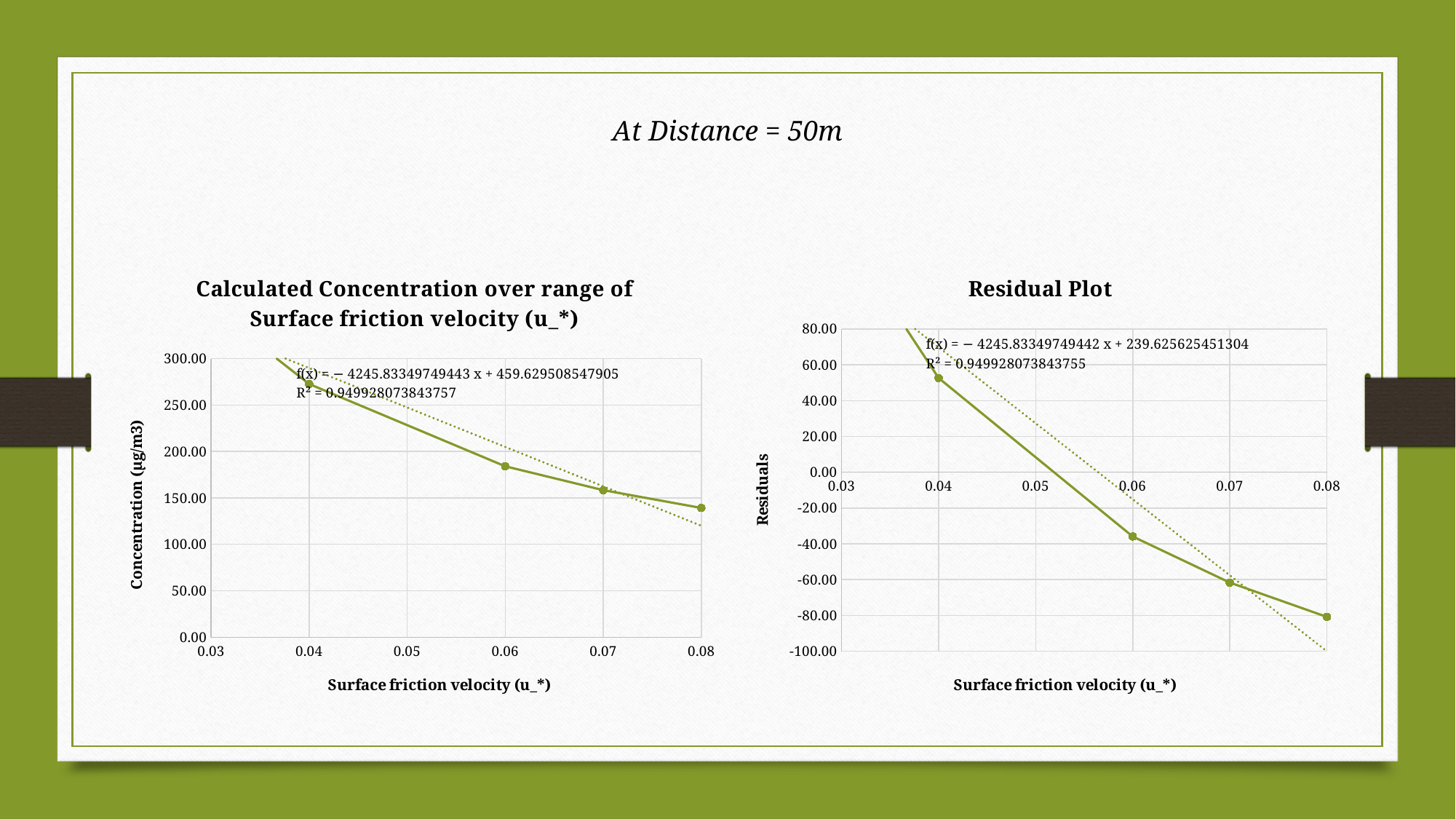
What R² value is printed on the 'Residual Plot' chart? 0.949928073843755 In the 'Calculated Concentration over range of Surface friction velocity (u_*)' chart, do the concentration values rise or fall as surface friction velocity increases? fall In the 'Calculated Concentration over range of Surface friction velocity (u_*)' chart, is the concentration at u_* = 0.06 greater or less than 200? less In the 'Residual Plot' chart, is the residual at u_* = 0.04 greater or less than 40? greater In the 'Calculated Concentration over range of Surface friction velocity (u_*)' chart, is the concentration at u_* = 0.04 greater or less than 250? greater In the 'Residual Plot' chart, which has the larger residual: u_* = 0.06 or u_* = 0.07? 0.06 What kind of chart is the 'Calculated Concentration over range of Surface friction velocity (u_*)' chart? line chart In the 'Residual Plot' chart, at which surface friction velocity is the residual lowest? 0.08 What is the y-axis label of the 'Calculated Concentration over range of Surface friction velocity (u_*)' chart? Concentration (µg/m3)